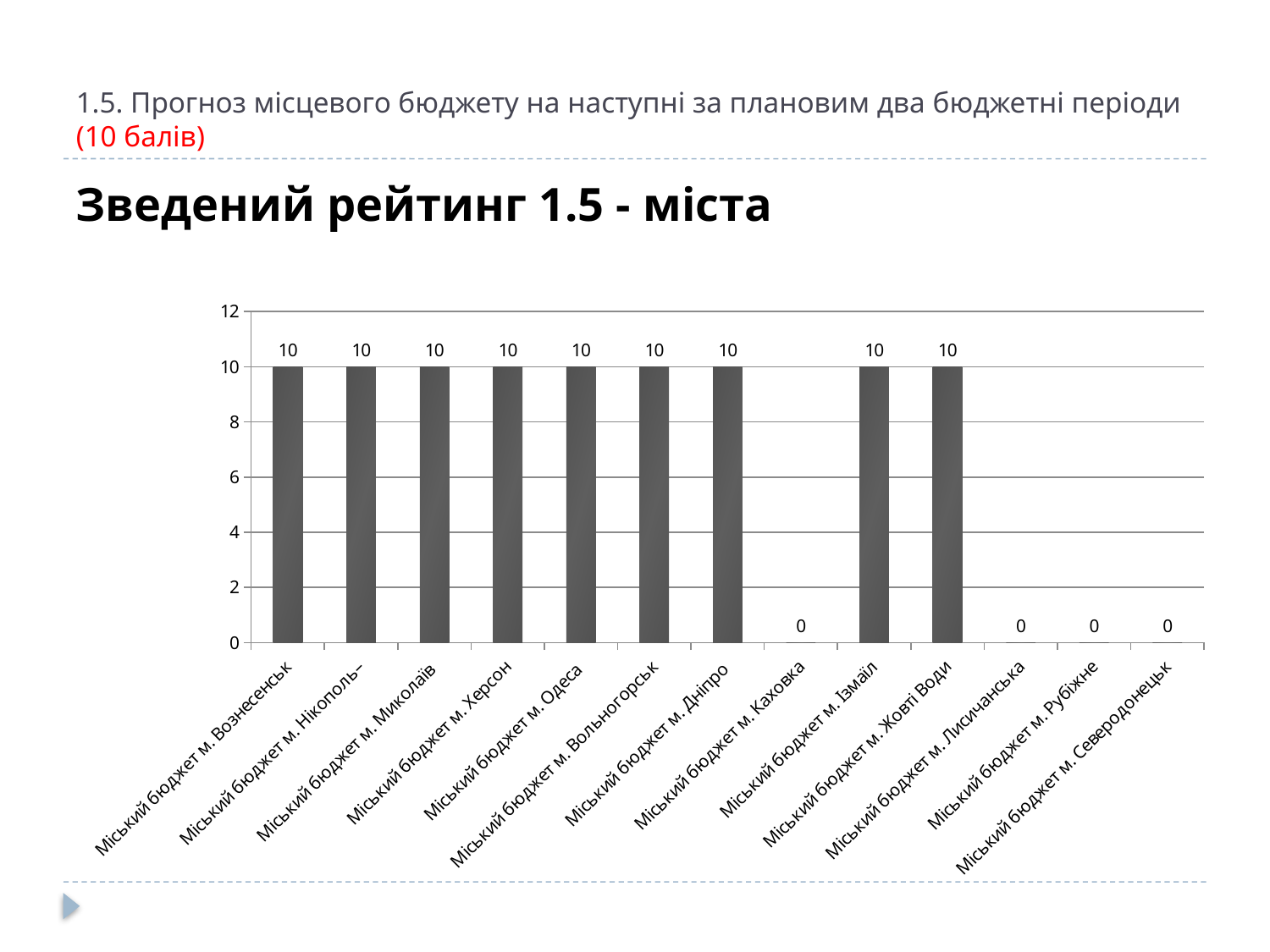
What is the value for Міський бюджет м. Одеса? 10 Is the value for Міський бюджет м. Херсон greater or less than 8? greater What is the value for Міський бюджет м. Каховка? 0 What is the value for Міський бюджет м. Жовті Води? 10 Which has the larger value, Міський бюджет м. Дніпро or Міський бюджет м. Рубіжне? Міський бюджет м. Дніпро What is the title of the chart? Зведений рейтинг 1.5 - міста What is the value for Міський бюджет м. Северодонецьк? 0 How many categories have a value of 0? 4 What is the highest value shown on the y axis? 12 What is the difference between the values for Міський бюджет м. Ізмаїл and Міський бюджет м. Лисичанська? 10 What kind of chart is shown on the slide? bar chart How many categories are shown on the x axis of the chart? 13